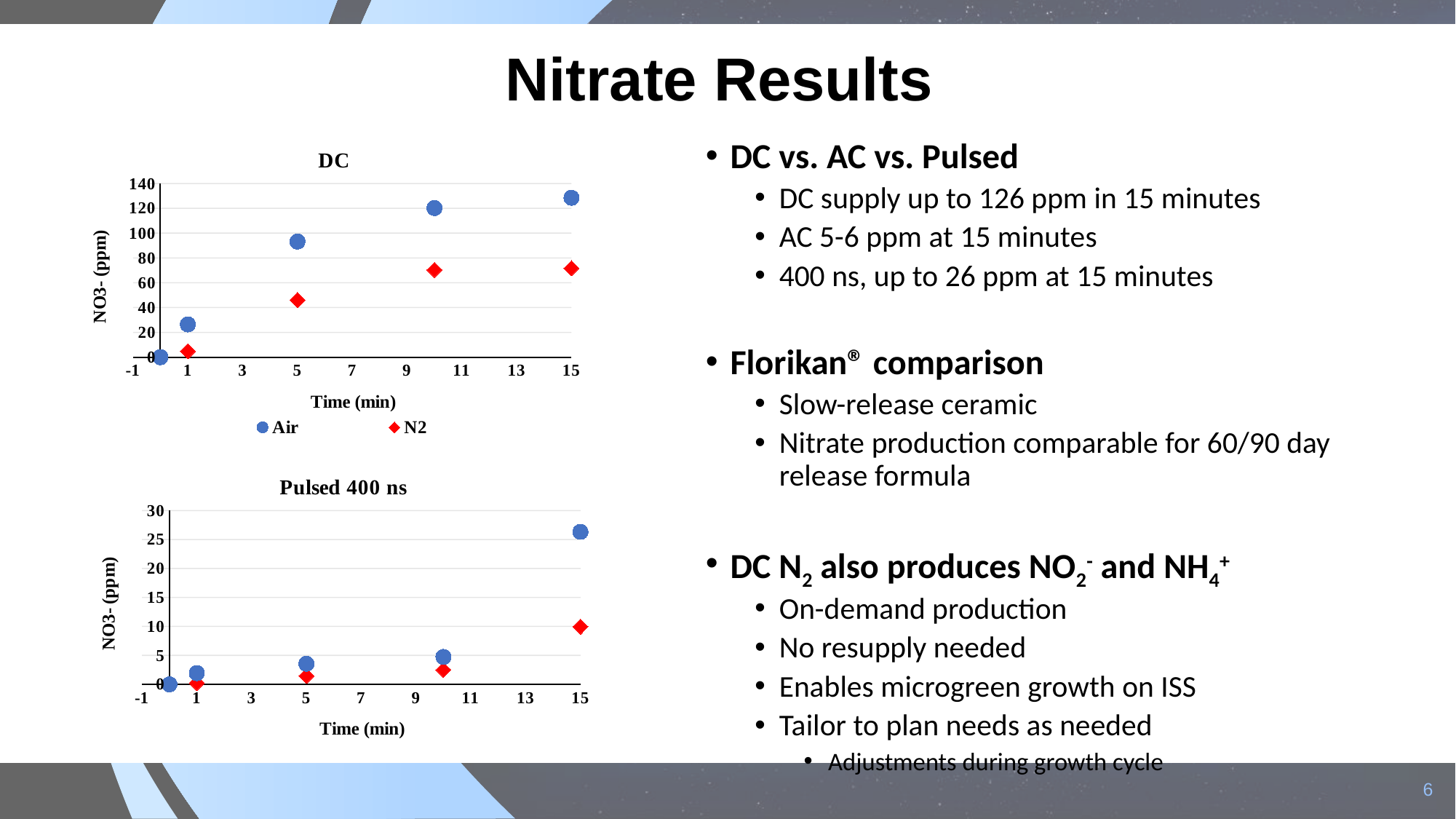
In the DC chart, is the Air value at 15 minutes greater or less than 120? greater What kind of chart is the DC chart? scatter chart In the DC chart, is the N2 value at 15 minutes greater or less than 80? less In the DC chart, which series has the higher value at 10 minutes, Air or N2? Air What is the label of the y axis on the Pulsed 400 ns chart? NO3- (ppm) In the Pulsed 400 ns chart, is the red diamond value at 15 minutes greater or less than 15? less In the Pulsed 400 ns chart, at which time is the blue circle series at its highest? 15 In the DC chart, do the Air values rise or fall as time increases? rise In the DC chart, how many data points are plotted for the Air series? 5 How many series does the legend of the DC chart list? 2